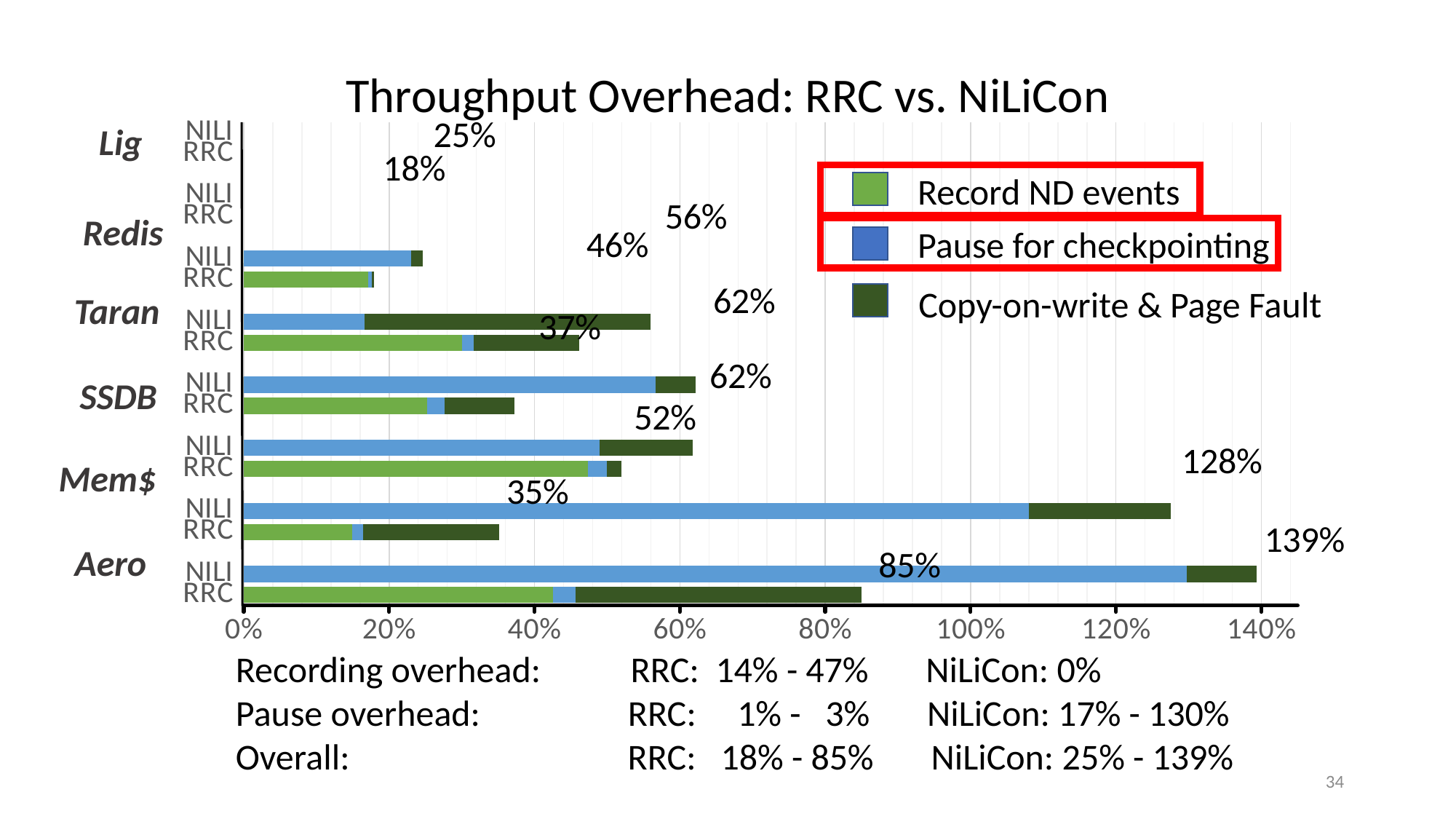
Which application has the highest labelled NiLiCon overhead? Aero Which legend entry is shown in dark green? Copy-on-write & Page Fault What is the labelled overall overhead for Aero under RRC? 85% How many series does the legend list? 3 What is the difference between the labelled NiLiCon and RRC overheads for Aero? 54% Which application has the lowest labelled RRC overhead? Lig How many applications (categories) are listed on the y axis? 6 What is the title of the chart? Throughput Overhead: RRC vs. NiLiCon Is the labelled NiLiCon overhead for Mem$ greater or less than 100%? greater What is the labelled overall overhead for Mem$ under NiLiCon (NILI)? 128% What kind of chart is shown on the slide? stacked bar chart What is the labelled overall overhead for Aero under NiLiCon (NILI)? 139%